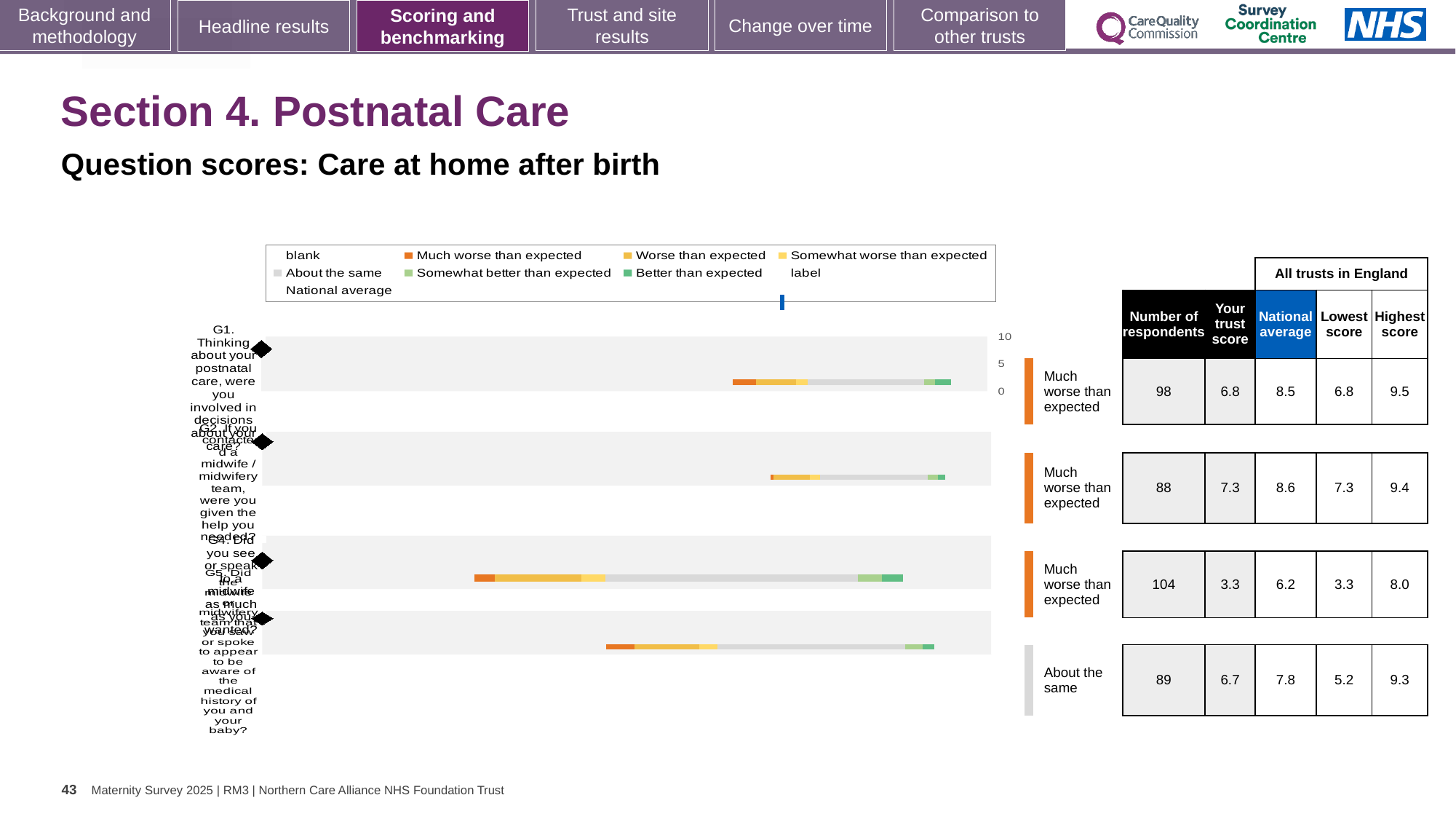
Which is larger, the trust score for the top row (G1) or for the second row (G2)? the second row (G2) Which row has the lowest trust score? the third row (G4), 3.3 Which row has the highest trust score? the second row (G2), 7.3 For the third row (G4), what is the difference between the national average and the trust score? 2.9 What is the trust score for the third row (G4) in the table beside the chart? 3.3 What is the highest score for the second row (G2)? 9.4 What kind of chart is shown on the slide? bar chart Which legend entry is shown in orange? Much worse than expected How many rows are rated 'Much worse than expected'? 3 What is the national average for the bottom row (G5)? 7.8 How many question rows (bars) are plotted in the chart? 4 In the table beside the chart, what is the number of respondents for the top row (G1)? 98